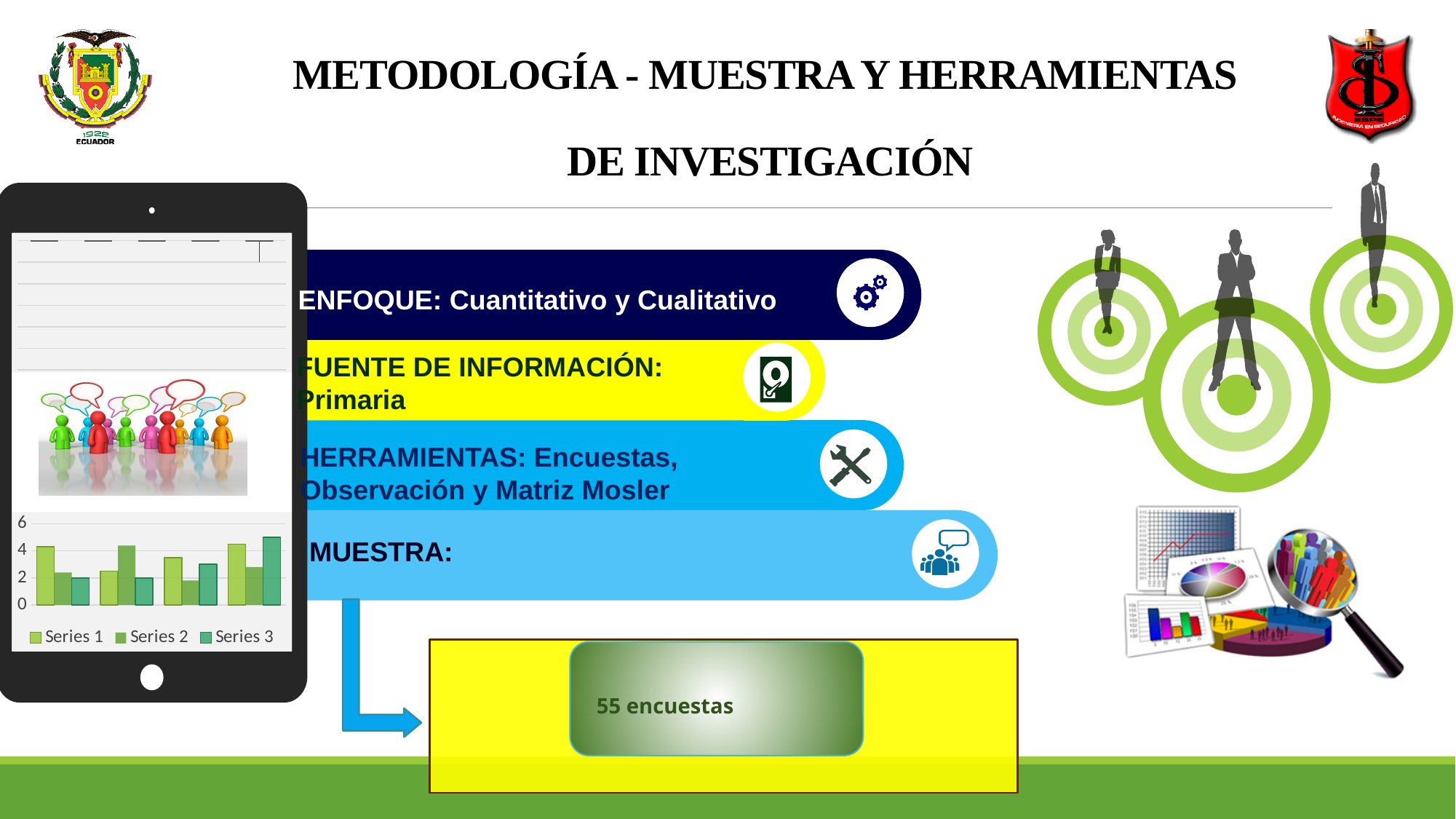
How many groups of bars are plotted in the bar chart on the tablet? 4 What kind of chart is shown on the tablet screen on the left of the slide? bar chart What is the highest tick value shown on the y axis of the bar chart on the tablet? 6 In the bar chart on the tablet, is the tallest bar greater or less than 4? greater What are the legend entries of the bar chart on the tablet? Series 1, Series 2, Series 3 How many series does the legend of the bar chart on the tablet list? 3 In the bar chart on the tablet, does any bar reach the value 6 on the y axis? No